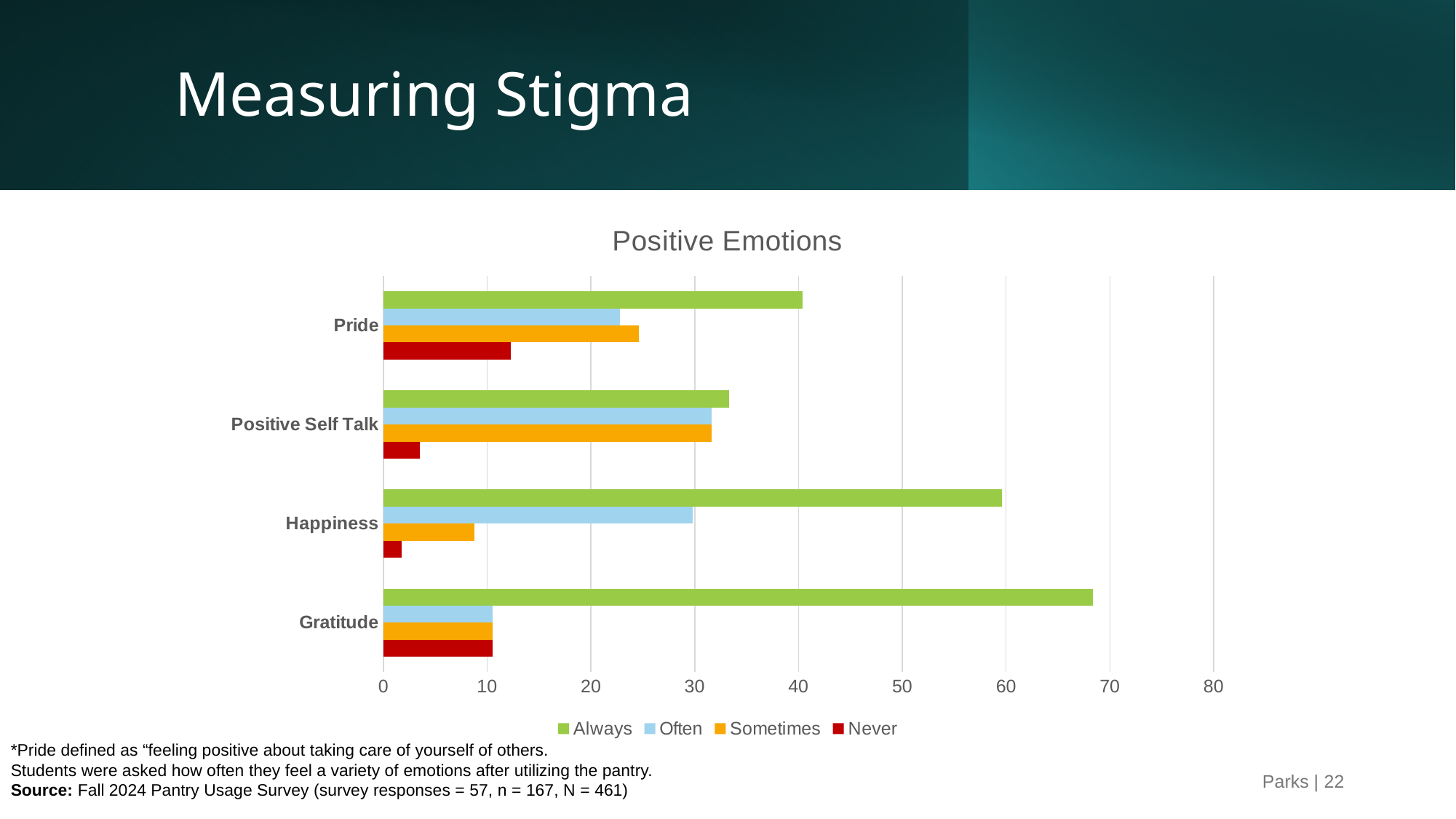
Is the Always value for Happiness greater or less than 50? greater How many emotion categories are plotted on the chart? 4 Which category has the highest value for Always? Gratitude Which has the larger Always value: Gratitude or Happiness? Gratitude Is the Always value for Gratitude greater or less than 60? greater What is the title of the chart? Positive Emotions What kind of chart is shown on the slide? bar chart Is the Never value for Positive Self Talk greater or less than 10? less For Happiness, which is larger: the Often value or the Sometimes value? Often How many series does the legend list? 4 Which category has the lowest value for Never? Happiness